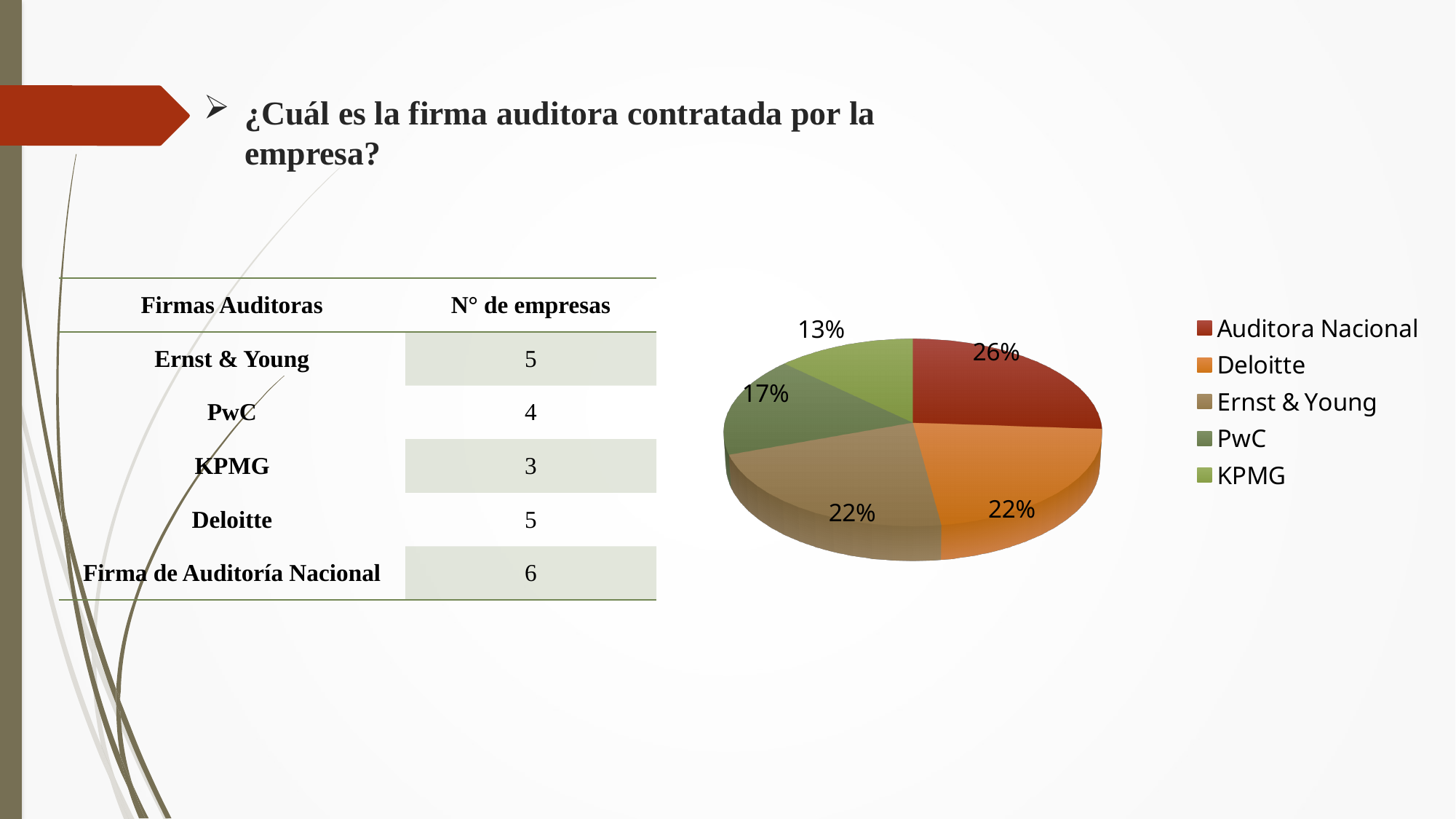
What percentage of the pie chart does PwC represent? 17% What percentage of the pie chart does Auditora Nacional represent? 26% How many entries does the legend of the pie chart list? 5 Which firm has the largest slice of the pie chart? Auditora Nacional What kind of chart is shown on the slide? pie chart What percentage of the pie chart does KPMG represent? 13% What is the difference in percentage points between the Auditora Nacional slice and the KPMG slice? 13 Which legend entry of the pie chart is shown in red? Auditora Nacional How many slices does the pie chart have? 5 What percentage of the pie chart does Deloitte represent? 22% Which slice is larger in the pie chart, PwC or Auditora Nacional? Auditora Nacional Which firm has the smallest slice of the pie chart? KPMG